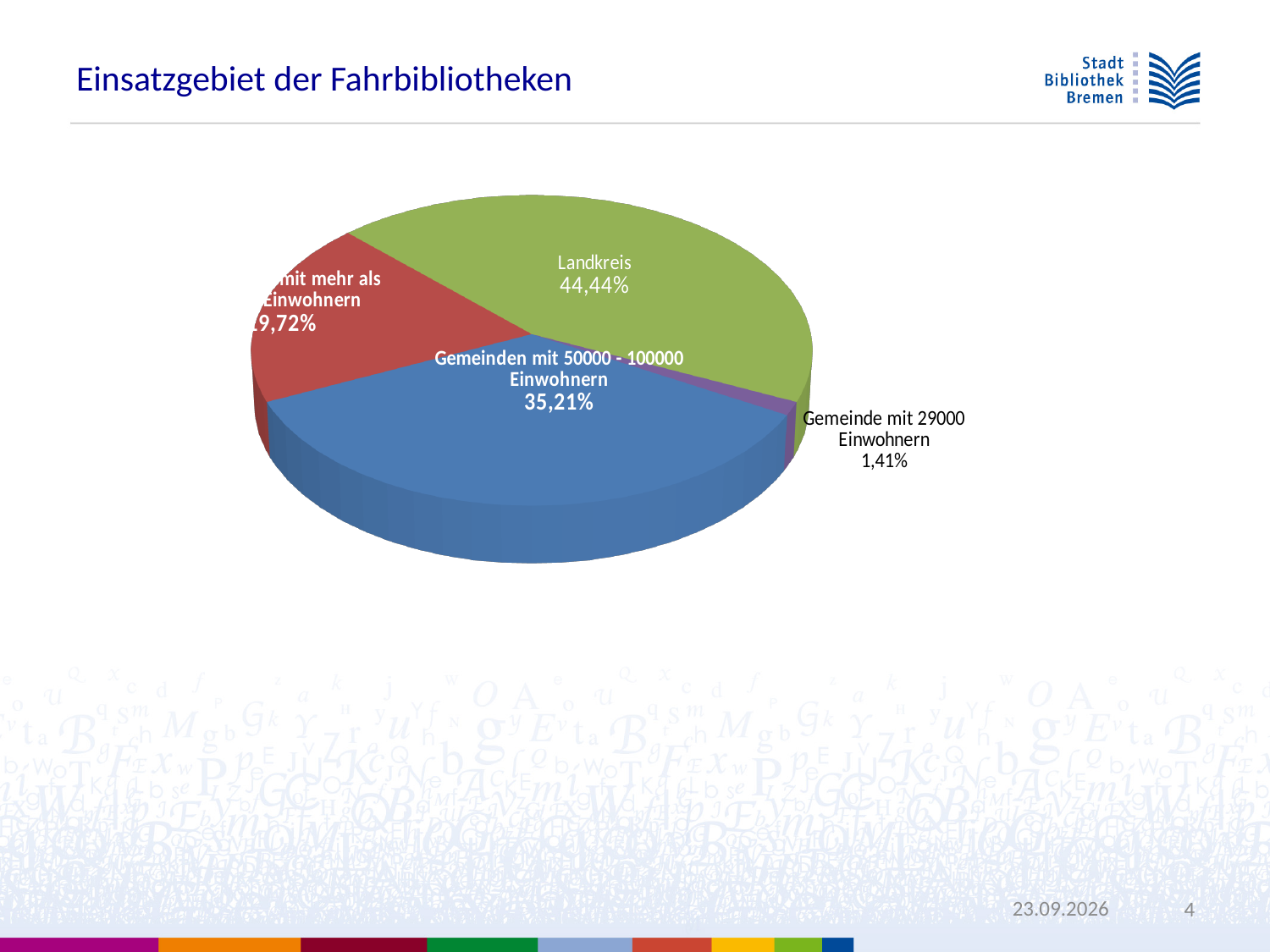
What kind of chart is shown on the slide? pie chart Which is larger: the share for Landkreis or the share for Gemeinden mit 50000 - 100000 Einwohnern? Landkreis How many slices does the pie chart have? 4 What is the title of the slide containing the pie chart? Einsatzgebiet der Fahrbibliotheken Which slice of the pie is the smallest? Gemeinde mit 29000 Einwohnern What percentage is shown for Gemeinden mit 50000 - 100000 Einwohnern? 35,21% By how many percentage points is the Landkreis share larger than the share for Gemeinden mit 50000 - 100000 Einwohnern? 9,23 percentage points Which slice of the pie is the largest? Landkreis What share of the pie does the Landkreis slice have? 44,44% What colour is the Landkreis slice of the pie? green What percentage is shown for Gemeinde mit 29000 Einwohnern? 1,41%